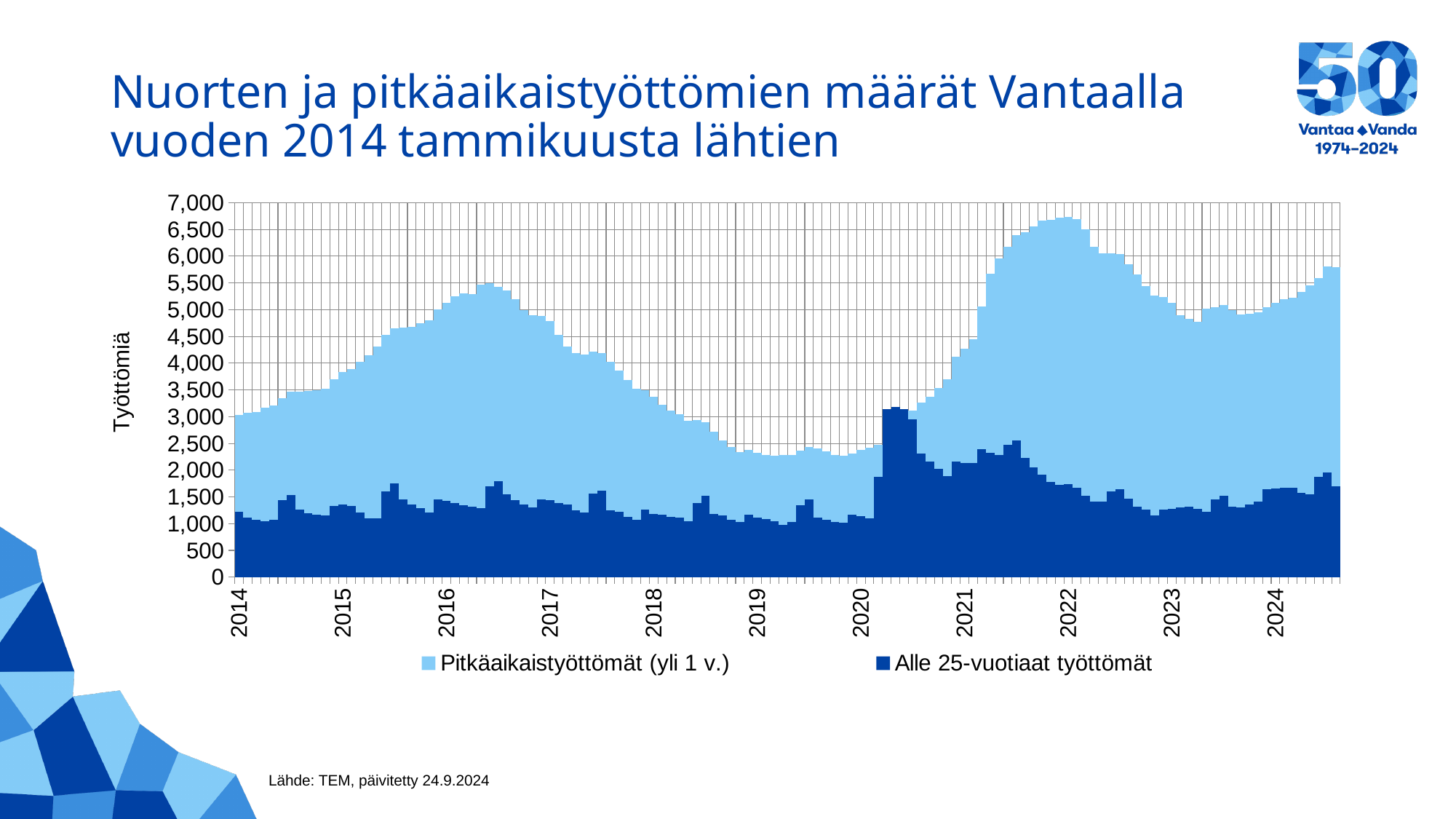
Does the total number of unemployed rise or fall from the start of 2014 to mid-2016? rise In which year does the total number of unemployed reach its highest level? 2022 Is the value for Alle 25-vuotiaat työttömät at its 2020 spike greater or less than 2,500? greater How many series does the legend list? 2 Which is higher: the total number of unemployed at the 2016 peak or at the 2022 peak? 2022 peak What are the two series named in the legend? Pitkäaikaistyöttömät (yli 1 v.) and Alle 25-vuotiaat työttömät Does the total number of unemployed rise or fall from mid-2016 to the start of 2019? fall What is the label on the vertical axis? Työttömiä Is the value for Alle 25-vuotiaat työttömät at the start of 2014 greater or less than 1,500? less Is the peak total number of unemployed in early 2022 greater or less than 6,000? greater